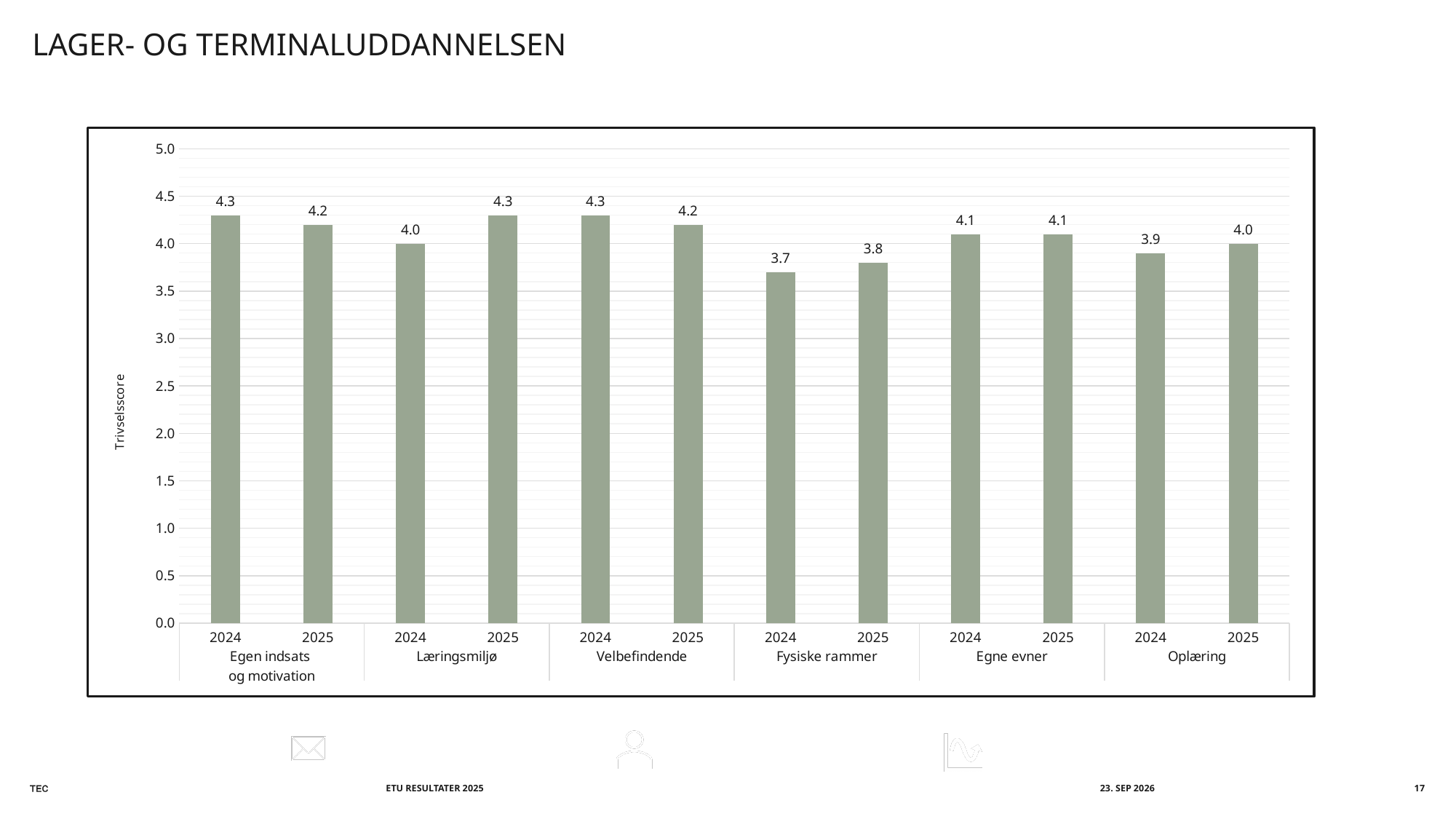
What is the Trivselsscore for Egen indsats og motivation in 2024? 4.3 What is the difference between the 2024 and 2025 Trivselsscore for Fysiske rammer? 0.1 What is the difference between the 2024 and 2025 Trivselsscore for Læringsmiljø? 0.3 How many categories (topics) are shown along the x axis of the chart? 6 What kind of chart is shown on the slide? bar chart What is the Trivselsscore for Oplæring in 2025? 4.0 What is the Trivselsscore for Læringsmiljø in 2025? 4.3 What is the Trivselsscore for Fysiske rammer in 2024? 3.7 Which bar has the lowest Trivselsscore on the chart? Fysiske rammer 2024 Which is larger: the 2024 or the 2025 Trivselsscore for Velbefindende? 2024 What is the label of the vertical axis of the chart? Trivselsscore Is the 2024 Trivselsscore for Oplæring greater or less than 4.0? less